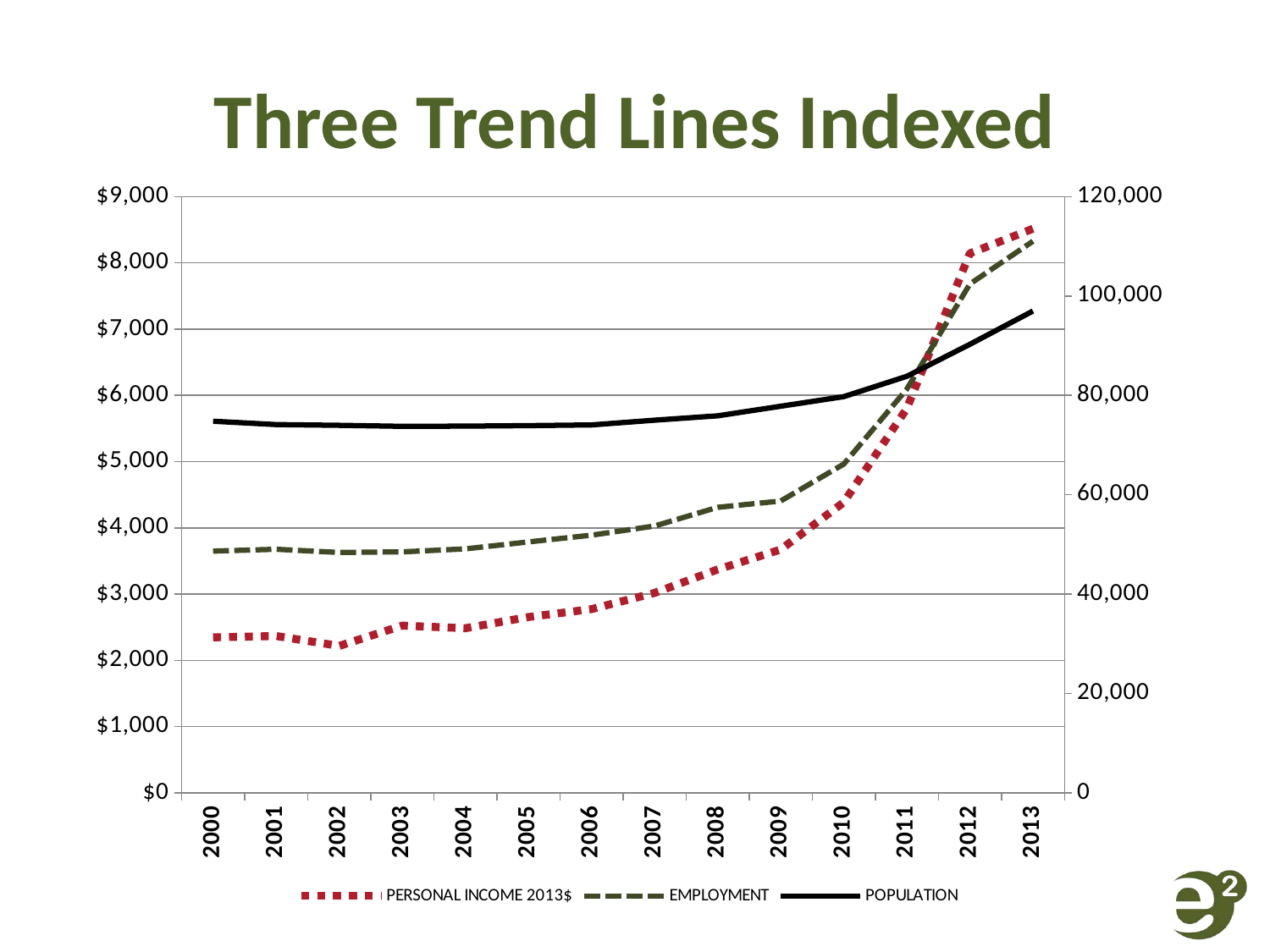
What type of chart is shown on the slide? line chart In which year is the PERSONAL INCOME 2013$ line at its highest? 2013 Does the PERSONAL INCOME 2013$ line rise or fall overall from 2000 to 2013? rise In 2000, which line is higher on the chart, EMPLOYMENT or POPULATION? POPULATION How many series does the legend list? 3 What is the title of the chart? Three Trend Lines Indexed Which series is drawn as a solid black line? POPULATION Is the PERSONAL INCOME 2013$ value for 2013 greater or less than $8,000 on the left axis? greater Is the PERSONAL INCOME 2013$ value for 2000 greater or less than $3,000 on the left axis? less Does the POPULATION line rise or fall overall from 2000 to 2013? rise How many years are shown along the x axis? 14 In which year is the PERSONAL INCOME 2013$ line at its lowest? 2002